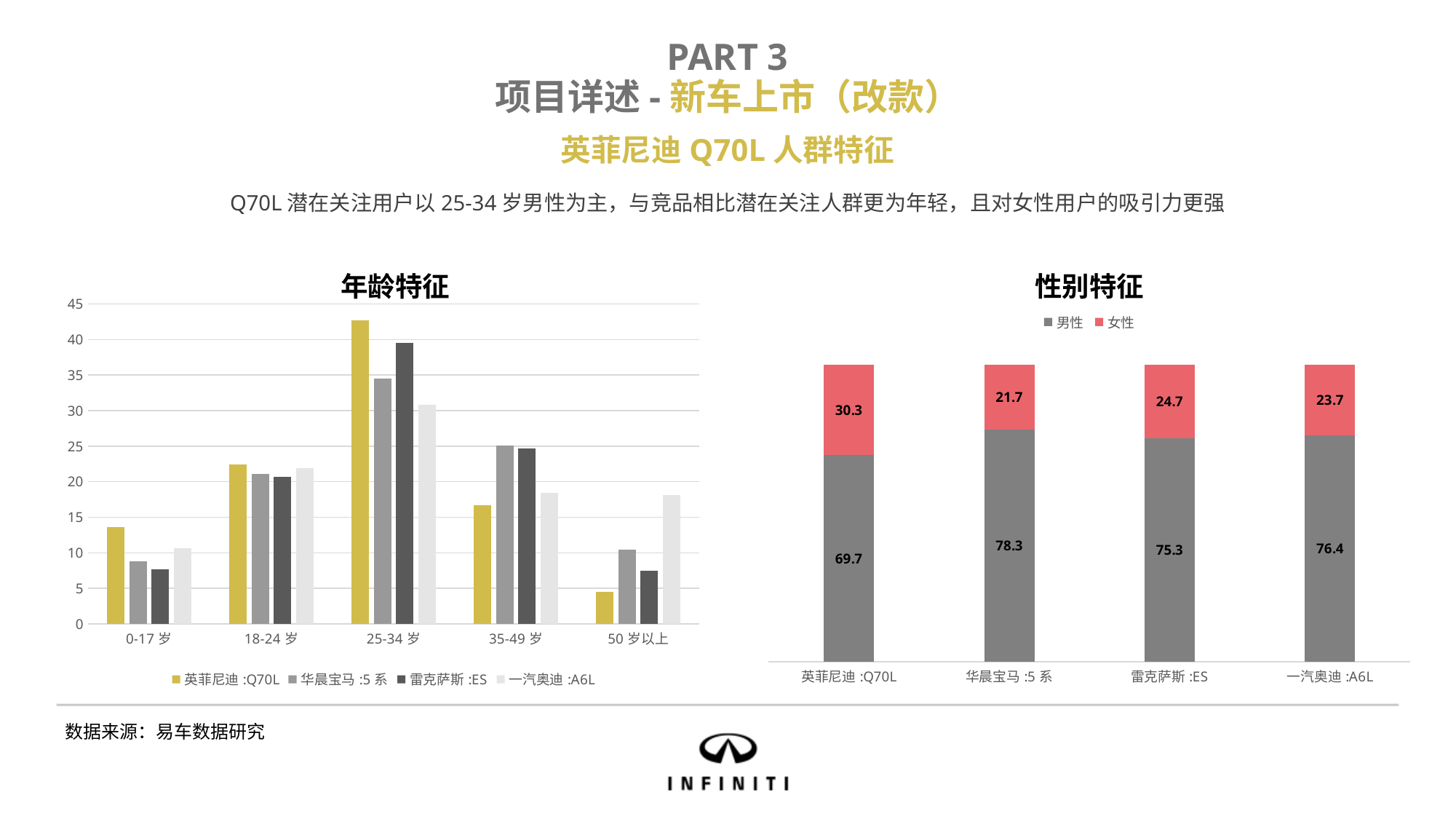
How many age categories are shown on the x axis of the 年龄特征 chart? 5 In the 年龄特征 chart, which age group has the highest value for 英菲尼迪:Q70L? 25-34 岁 What type of chart is the 年龄特征 chart on the left? bar chart In the 年龄特征 chart, is the value for 一汽奥迪:A6L in the 50 岁以上 group greater or less than 15? greater In the 性别特征 chart, what is the difference between the 女性 values for 英菲尼迪:Q70L and 华晨宝马:5 系? 8.6 In the 性别特征 chart, what is the 男性 value for 英菲尼迪:Q70L? 69.7 In the 年龄特征 chart, in the 50 岁以上 group, which is larger: 英菲尼迪:Q70L or 一汽奥迪:A6L? 一汽奥迪:A6L In the 性别特征 chart, what is the total of the stacked bar for 雷克萨斯:ES? 100 In the 年龄特征 chart, is the value for 英菲尼迪:Q70L in the 25-34 岁 group greater or less than 40? greater How many series does the legend of the 年龄特征 chart list? 4 In the 性别特征 chart, which model has the highest 女性 value? 英菲尼迪:Q70L In the 性别特征 chart, what is the 女性 value for 华晨宝马:5 系? 21.7